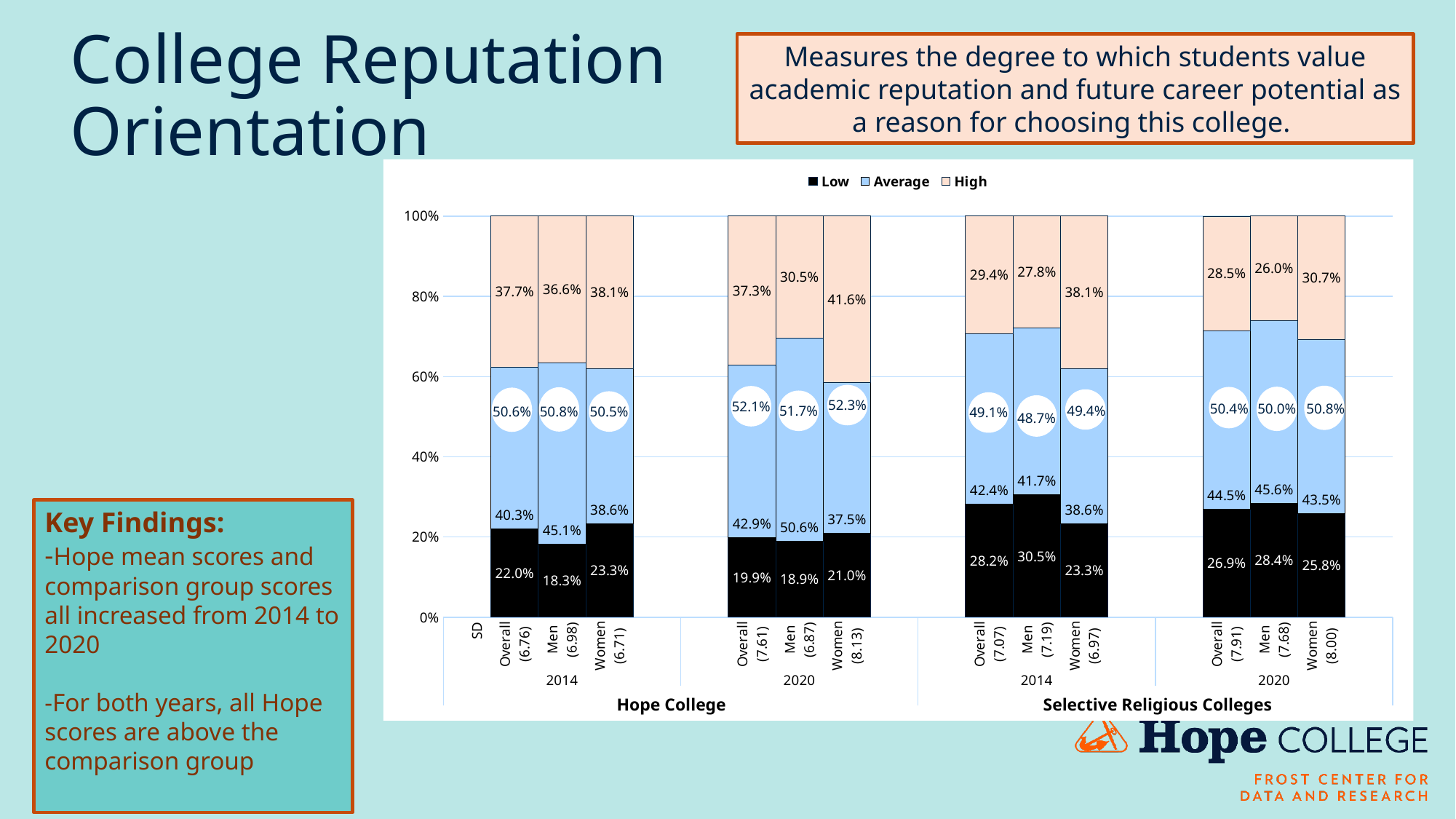
What is the Low percentage for Hope College Men in 2014? 18.3% How many series does the chart legend list? 3 Which bar has the highest Low percentage? Selective Religious Colleges Men 2014 (30.5%) What is the difference between the High percentage for Hope College Women in 2020 and Hope College Men in 2020? 11.1 percentage points Which bar has the lowest Low percentage? Hope College Men 2014 (18.3%) Which has the larger Low percentage in 2020: Hope College Overall or Selective Religious Colleges Overall? Selective Religious Colleges Overall What is the High percentage for Hope College Women in 2020? 41.6% What kind of chart is shown on the slide? Stacked bar chart Which bar has the highest High percentage? Hope College Women 2020 (41.6%) What is the standard deviation shown in parentheses for Hope College Women in 2020? 8.13 What are the three series named in the chart legend? Low, Average, High What is the Average percentage for Selective Religious Colleges Men in 2020? 45.6%